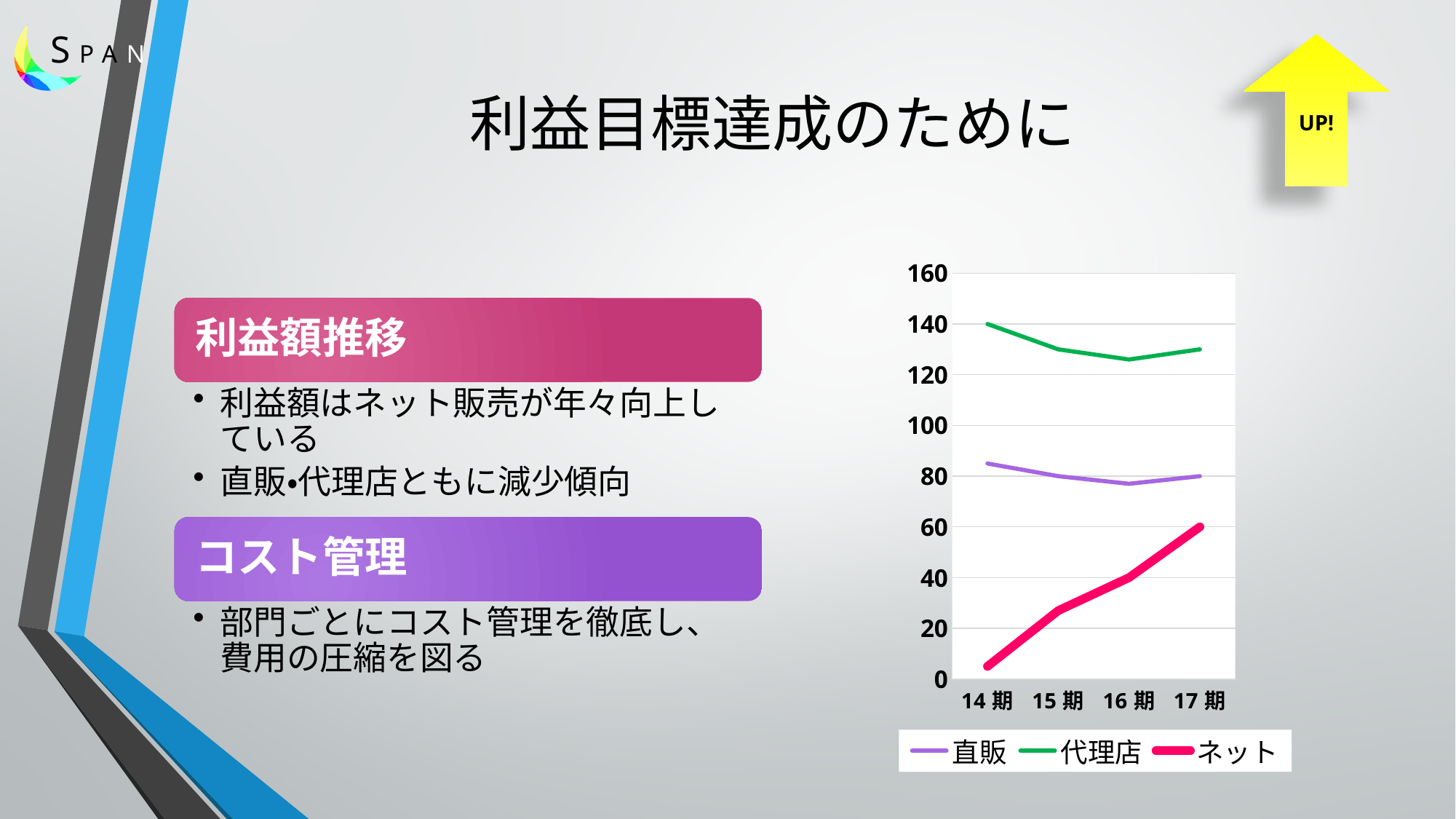
How many series does the chart legend list? 3 Which series has the highest value in 14期? 代理店 Is the value for 直販 in 14期 greater or less than 80? greater What is the value for ネット in 17期? 60 What kind of chart is shown on the slide? line chart Is the value for 代理店 in 16期 greater or less than 120? greater What is the value for 直販 in 17期? 80 What is the value for 代理店 in 14期? 140 Which series has the lowest value in 17期? ネット How many periods are shown on the x axis of the chart? 4 Is the value for ネット in 14期 greater or less than 20? less Do the values for ネット rise or fall from 14期 to 17期? rise